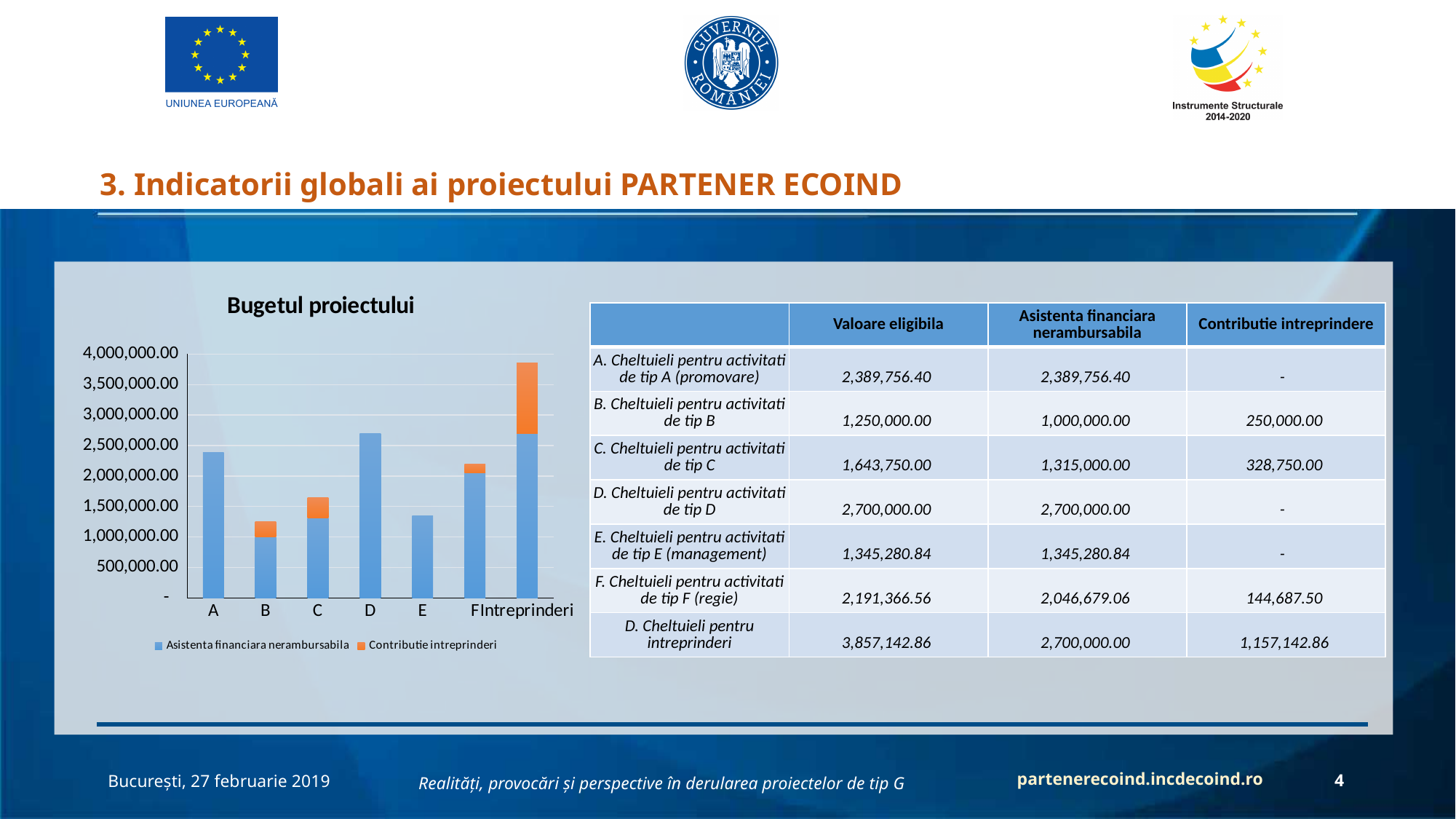
Which colour represents "Contributie intreprinderi" in the "Bugetul proiectului" chart? orange What is the title of the chart on the slide? Bugetul proiectului In the "Bugetul proiectului" chart, is the total stacked value for Intreprinderi greater or less than 3,500,000.00? greater Which category has the tallest stacked bar in the "Bugetul proiectului" chart? Intreprinderi What type of chart is shown under the title "Bugetul proiectului"? bar chart In the "Bugetul proiectului" chart, is the value for D greater or less than 2,500,000.00? greater Which category has the shortest "Asistenta financiara nerambursabila" bar in the "Bugetul proiectului" chart? B In the "Bugetul proiectului" chart, is the total stacked value for C greater or less than 1,500,000.00? greater How many categories are shown on the x axis of the "Bugetul proiectului" chart? 7 In the "Bugetul proiectului" chart, is the "Asistenta financiara nerambursabila" value for D larger or smaller than that for A? larger How many series does the legend of the "Bugetul proiectului" chart list? 2